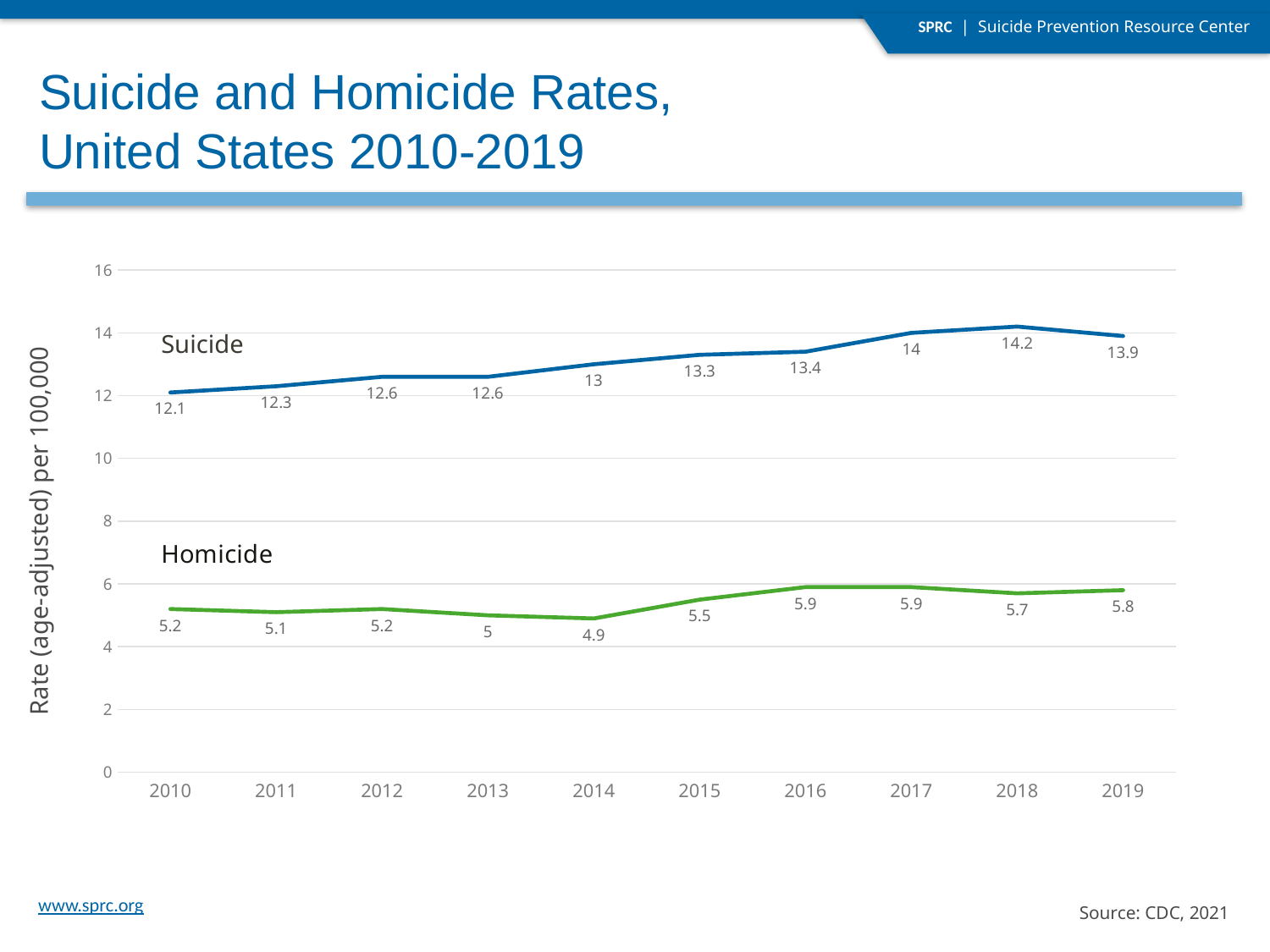
In which year was the homicide rate lowest? 2014 In which year was the suicide rate highest? 2018 By how much did the suicide rate change from 2010 to 2019? 1.8 Which was higher, the homicide rate in 2016 or in 2018? 2016 What was the suicide rate in 2010? 12.1 What kind of chart is shown on the slide? Line chart What was the suicide rate in 2018? 14.2 What is the label of the y axis? Rate (age-adjusted) per 100,000 What is the difference between the suicide rate and the homicide rate in 2019? 8.1 What was the homicide rate in 2014? 4.9 How many series are plotted on the chart? 2 How many years are shown on the x axis? 10